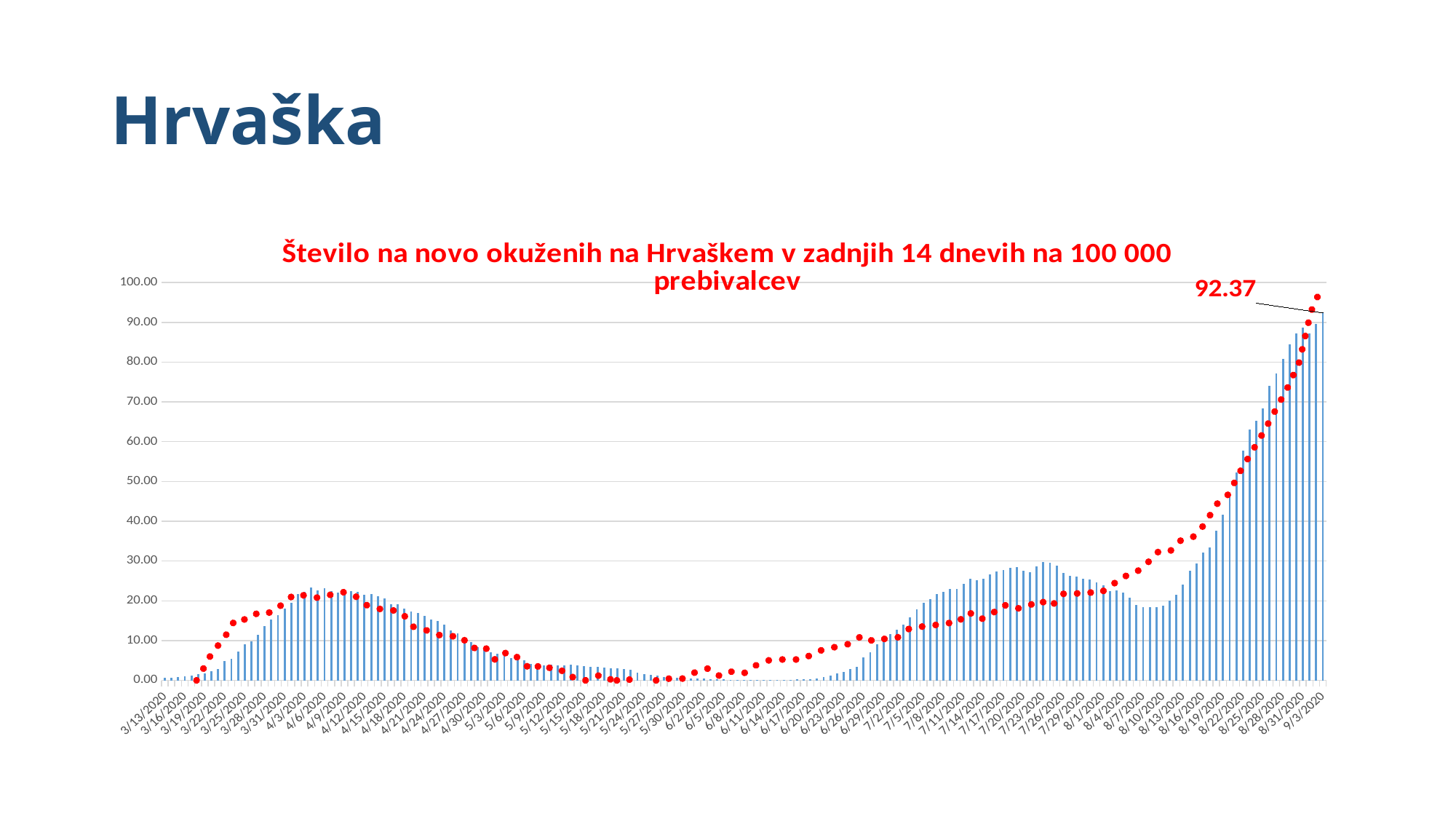
Is the value for 8/28/2020 greater or less than 70? greater On which date does the chart reach its highest value? 9/3/2020 What is the highest value shown on the vertical axis? 100.00 What value is printed as a data label at the end of the red dotted series? 92.37 What is the title of the chart? Število na novo okuženih na Hrvaškem v zadnjih 14 dnevih na 100 000 prebivalcev Is the value for 4/6/2020 greater or less than 10? greater Is the value for 7/23/2020 greater or less than 20? greater Do the values rise or fall between 8/7/2020 and 9/3/2020? rise Which date has the larger value, 8/28/2020 or 7/23/2020? 8/28/2020 Do the values rise or fall between 4/9/2020 and 5/30/2020? fall What kind of chart is shown on the slide? bar chart with a dotted line overlay